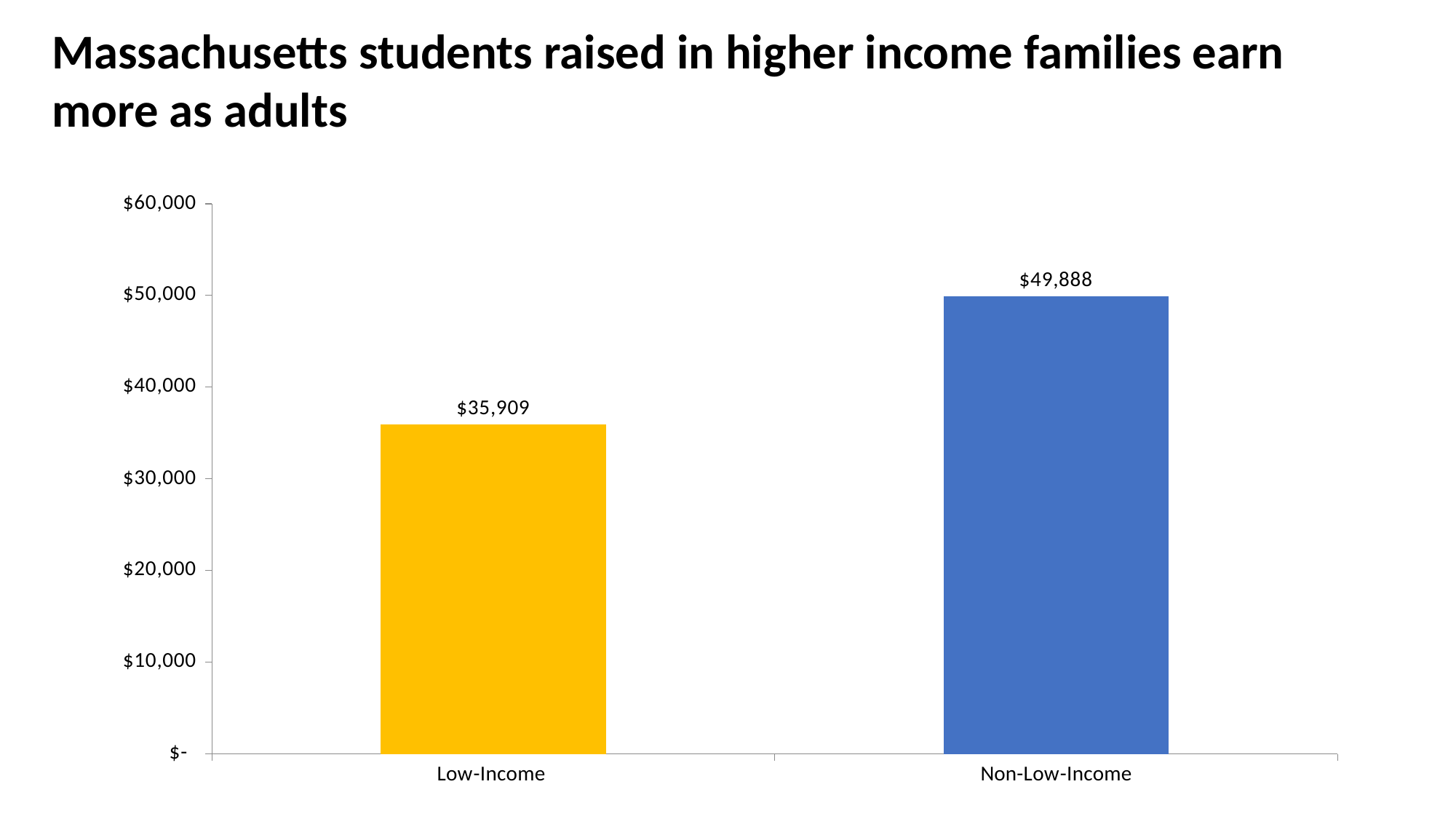
How many categories are shown on the x axis? 2 Which is larger, the value for Low-Income or the value for Non-Low-Income? Non-Low-Income What is the title of the slide? Massachusetts students raised in higher income families earn more as adults What colour is the Low-Income bar? yellow What kind of chart is shown on the slide? bar chart What is the value for Low-Income? $35,909 Is the value for Low-Income greater or less than $40,000? less What is the value for Non-Low-Income? $49,888 What is the difference between the Non-Low-Income and Low-Income values? $13,979 Is the value for Non-Low-Income greater or less than $40,000? greater Which category has the highest value? Non-Low-Income Which category has the lowest value? Low-Income